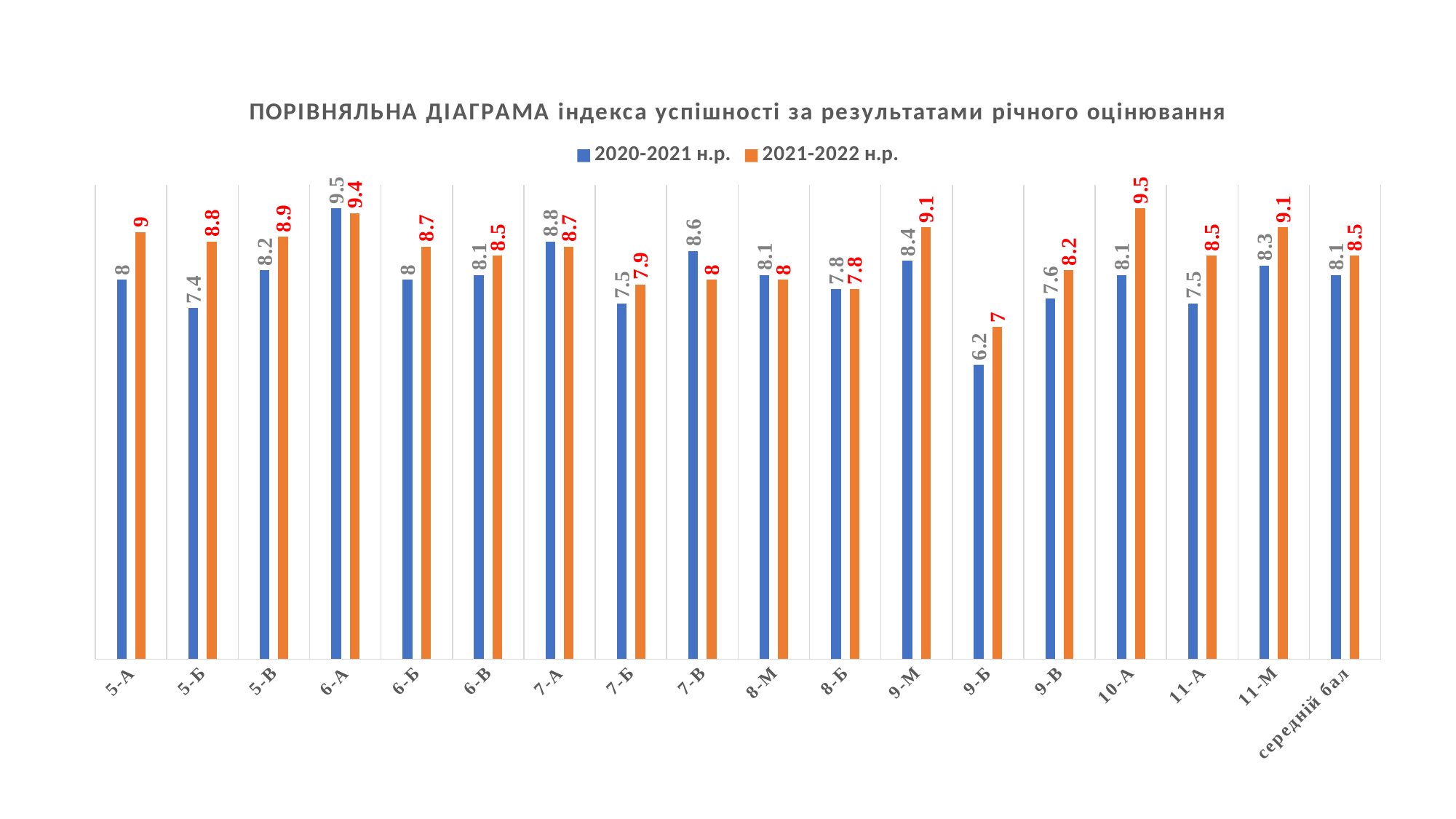
Which category has the highest value in the 2020-2021 н.р. series? 6-А What type of chart is shown on the slide? bar chart What is the value for 9-М in the 2021-2022 н.р. series? 9.1 Which category has the highest value in the 2021-2022 н.р. series? 10-А How many series does the legend list? 2 What is the value for 5-Б in the 2020-2021 н.р. series? 7.4 What is the difference between the 2021-2022 н.р. and 2020-2021 н.р. values for 10-А? 1.4 For 7-В, which series has the larger value, 2020-2021 н.р. or 2021-2022 н.р.? 2020-2021 н.р. What is the value for середній бал in the 2021-2022 н.р. series? 8.5 Which colour represents the 2021-2022 н.р. series? orange Which category has the lowest value in the 2021-2022 н.р. series? 9-Б How many categories are shown on the x axis? 18